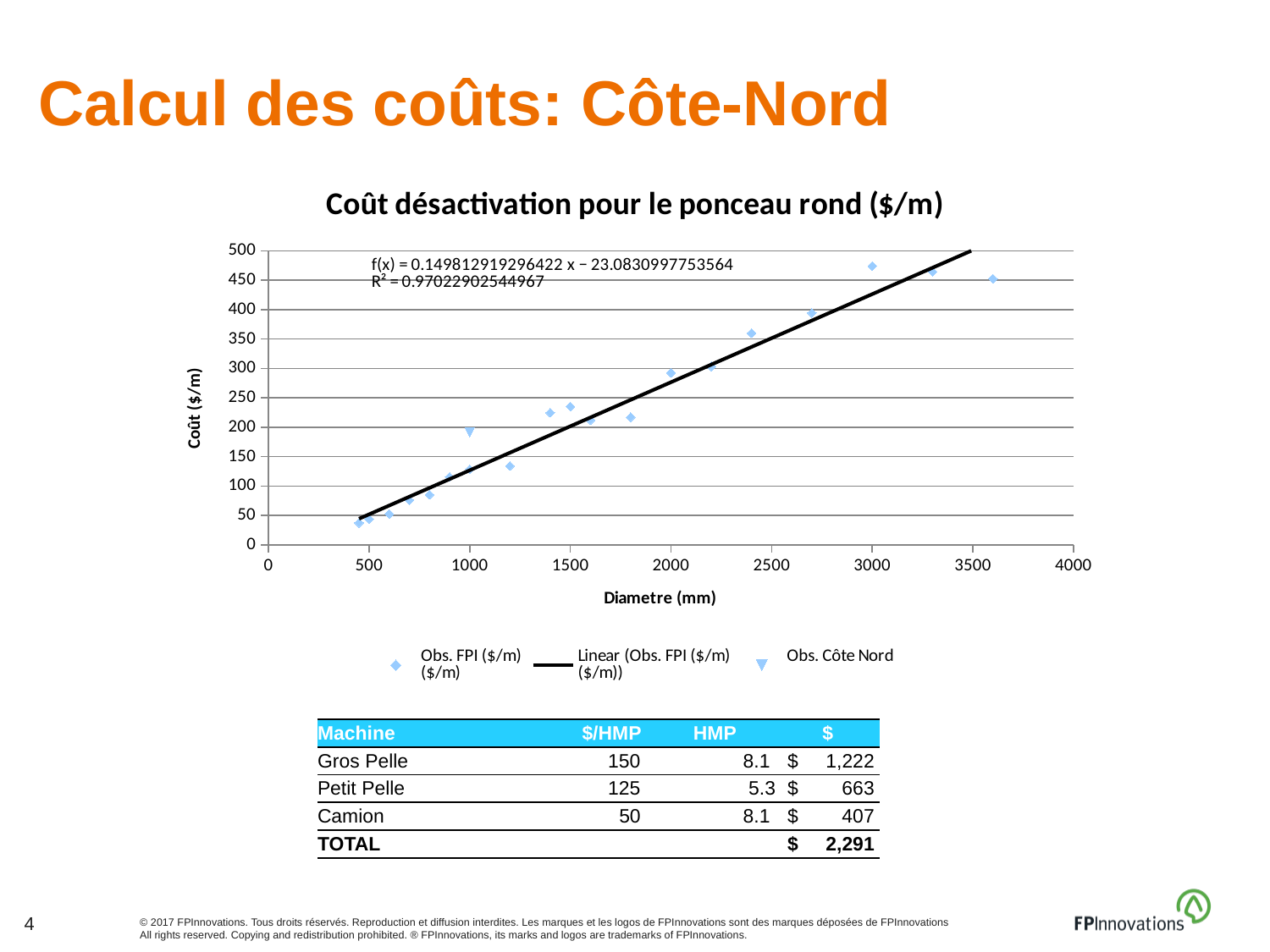
Is the Obs. FPI ($/m) value at a diameter of 500 mm greater or less than 100? less What is the label of the x axis of the chart? Diametre (mm) Is the Obs. FPI ($/m) value at a diameter of 1200 mm greater or less than 150? less Is the Obs. Côte Nord value at a diameter of 1000 mm greater or less than 150? greater How many series does the chart legend list? 3 Which series has the higher value at a diameter of 3000 mm: Obs. FPI ($/m) or the Linear trendline? Obs. FPI ($/m) What type of chart is shown on the slide? scatter chart Do the Obs. FPI ($/m) values rise or fall as the diameter increases along the x axis? rise How many Obs. Côte Nord points are plotted on the chart? 1 What is the title of the chart? Coût désactivation pour le ponceau rond ($/m)